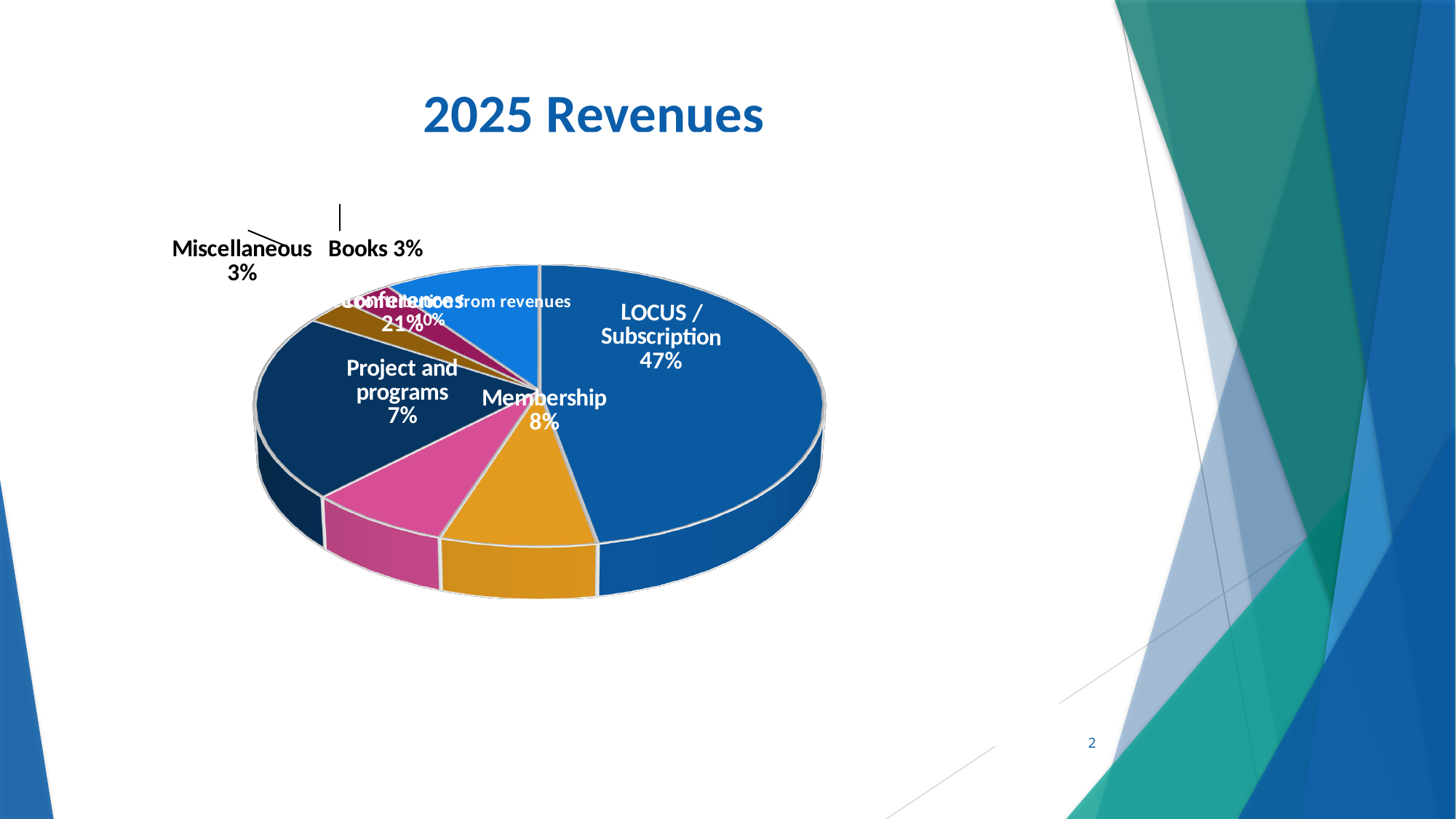
Which revenue category has the largest share of the pie? LOCUS / Subscription What percentage of 2025 revenues comes from Books? 3% Which is larger, the share for LOCUS / Subscription or the share for Membership? LOCUS / Subscription What share of 2025 revenues is labelled Miscellaneous? 3% What percentage of 2025 revenues comes from Project and programs? 7% How many percentage points larger is the LOCUS / Subscription share than the Membership share? 39% What percentage of 2025 revenues is Membership? 8% What is the title of the chart? 2025 Revenues What kind of chart is shown on the slide? pie chart What share of 2025 revenues comes from LOCUS / Subscription? 47% What is the difference between the Membership share and the Project and programs share? 1% Which is larger, the share for Membership or the share for Project and programs? Membership